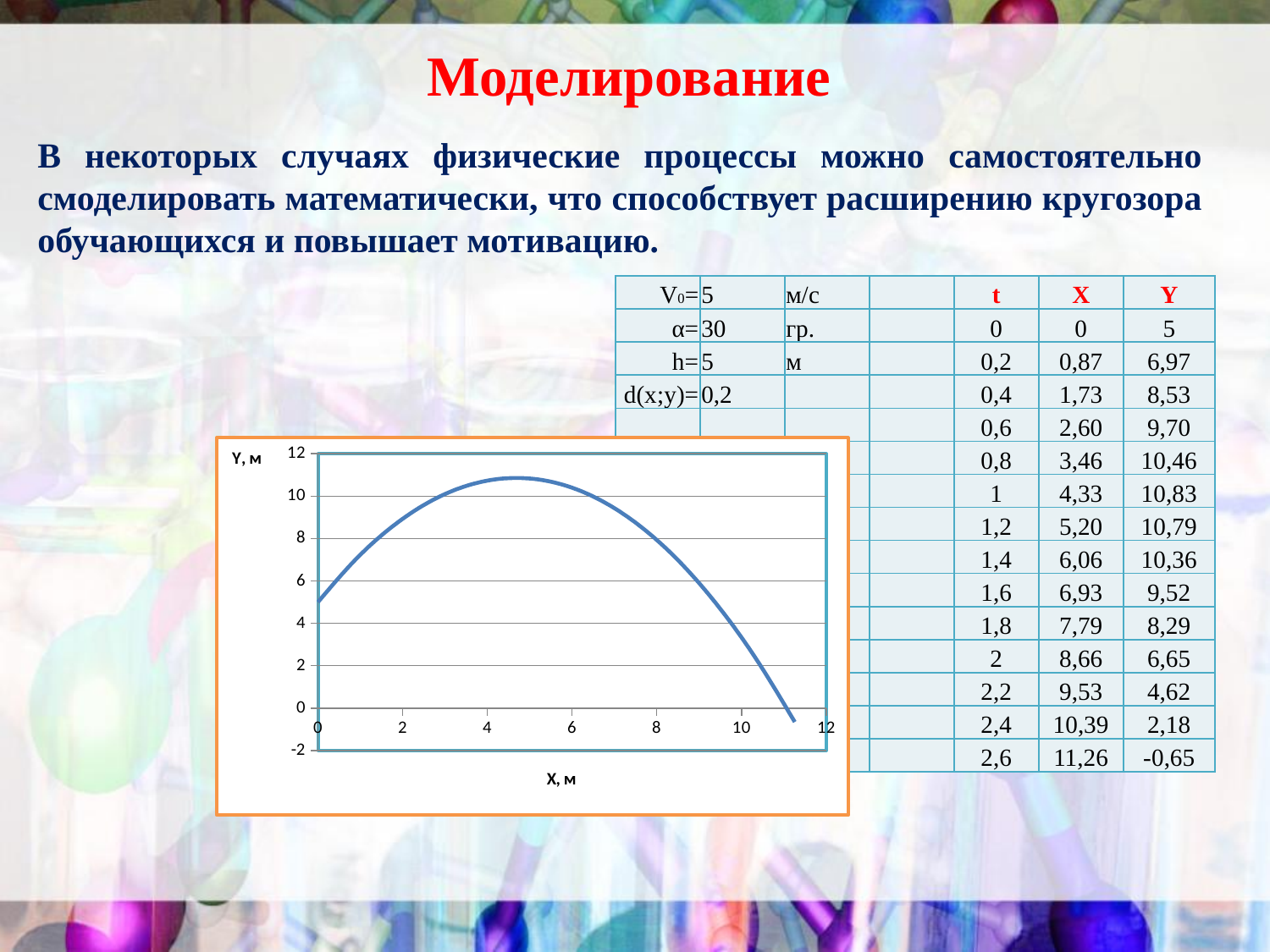
What kind of chart is shown on the slide? line chart Is the highest point of the curve above or below Y = 10? above Is the value of Y at X = 0 greater or less than 4? greater Does the curve rise or fall as X increases from 6 to 10? falls What is the title of the horizontal axis of the chart? X, м Is the value of Y at X = 10 greater or less than 6? less What is the title of the vertical axis of the chart? Y, м What is the highest tick value shown on the vertical axis of the chart? 12 Is the value of Y larger at X = 4 or at X = 10? X = 4 Does the curve rise or fall as X increases from 0 to 4? rises